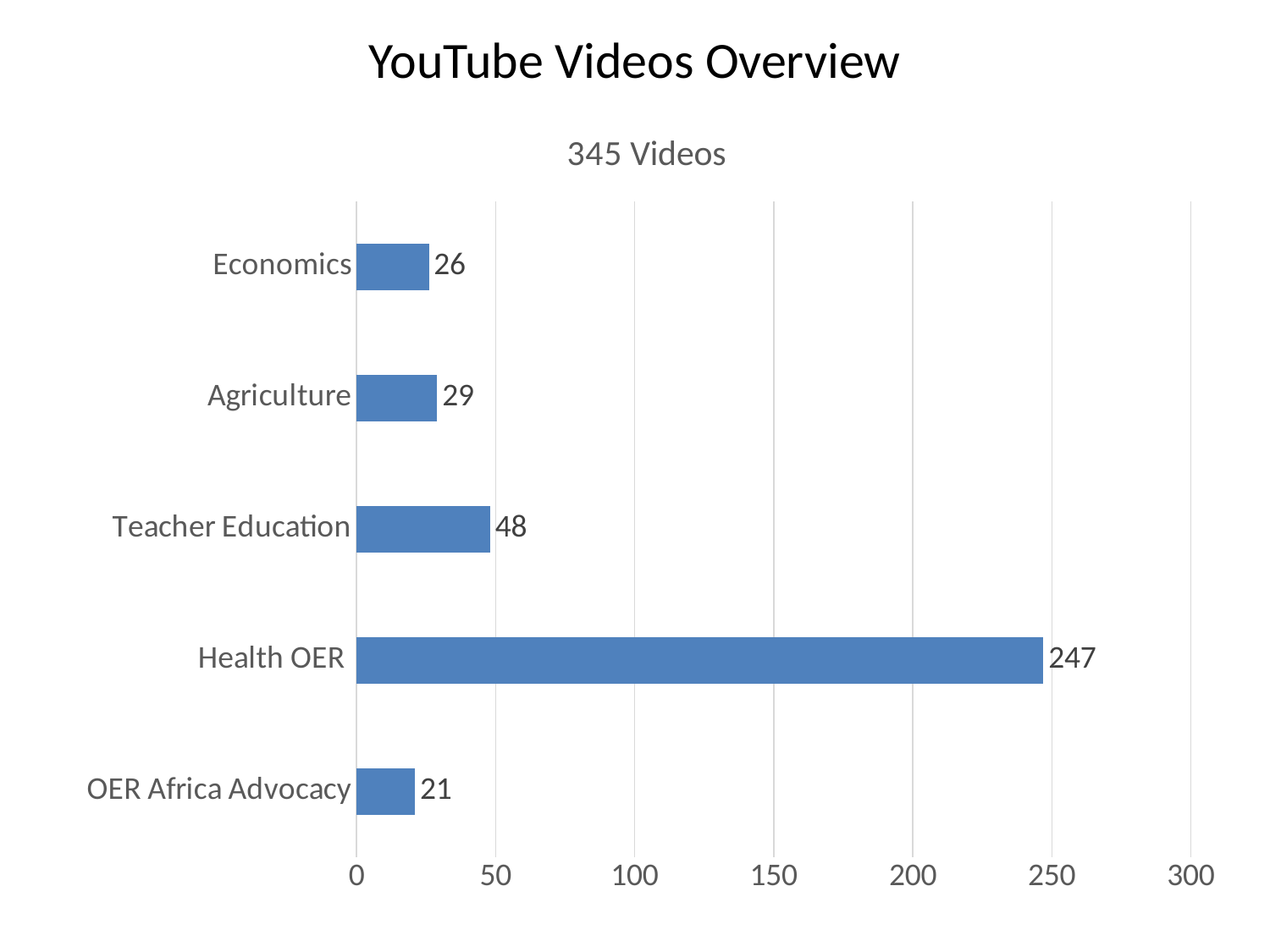
How many videos does the chart show for Health OER? 247 What is the value for Teacher Education? 48 What is the value for OER Africa Advocacy? 21 What is the difference between the values for Health OER and Teacher Education? 199 Which is larger, the value for Teacher Education or the value for Agriculture? Teacher Education What kind of chart is shown on the slide? bar chart Is the value for Health OER greater or less than 200? greater Which category has the highest value? Health OER How many categories are shown in the chart? 5 What is the difference between the values for Agriculture and Economics? 3 What is the chart's title? 345 Videos Which category has the lowest value? OER Africa Advocacy